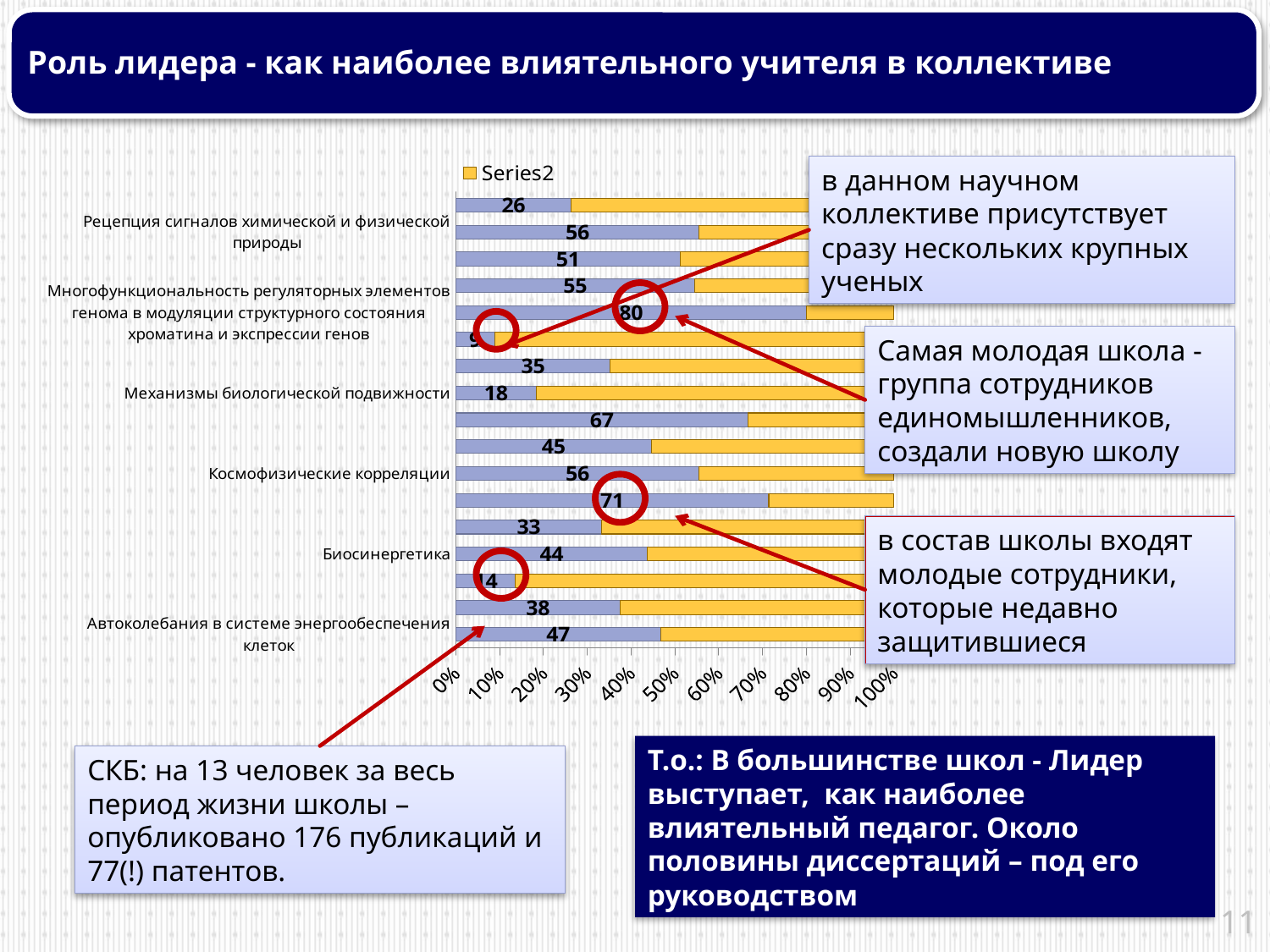
What is the highest data label shown on the blue segments of the chart? 80 Is the blue segment labelled 80 greater or less than 50% on the axis? greater What is the data label on the blue segment of the bar for 'Биосинергетика'? 44 What is the lowest data label shown on the blue segments of the chart? 9 What is the data label on the blue segment of the bar for 'Механизмы биологической подвижности'? 18 What is the maximum value shown on the horizontal axis of the chart? 100% What entry is shown in the chart legend? Series2 What is the difference between the blue segment labelled 80 and the blue segment labelled 9? 71 Which is larger, the blue segment labelled 67 or the blue segment labelled 45? 67 What is the data label on the blue segment of the bar for 'Космофизические корреляции'? 56 What kind of chart is shown on the slide? bar chart How many bars are plotted in the chart? 17